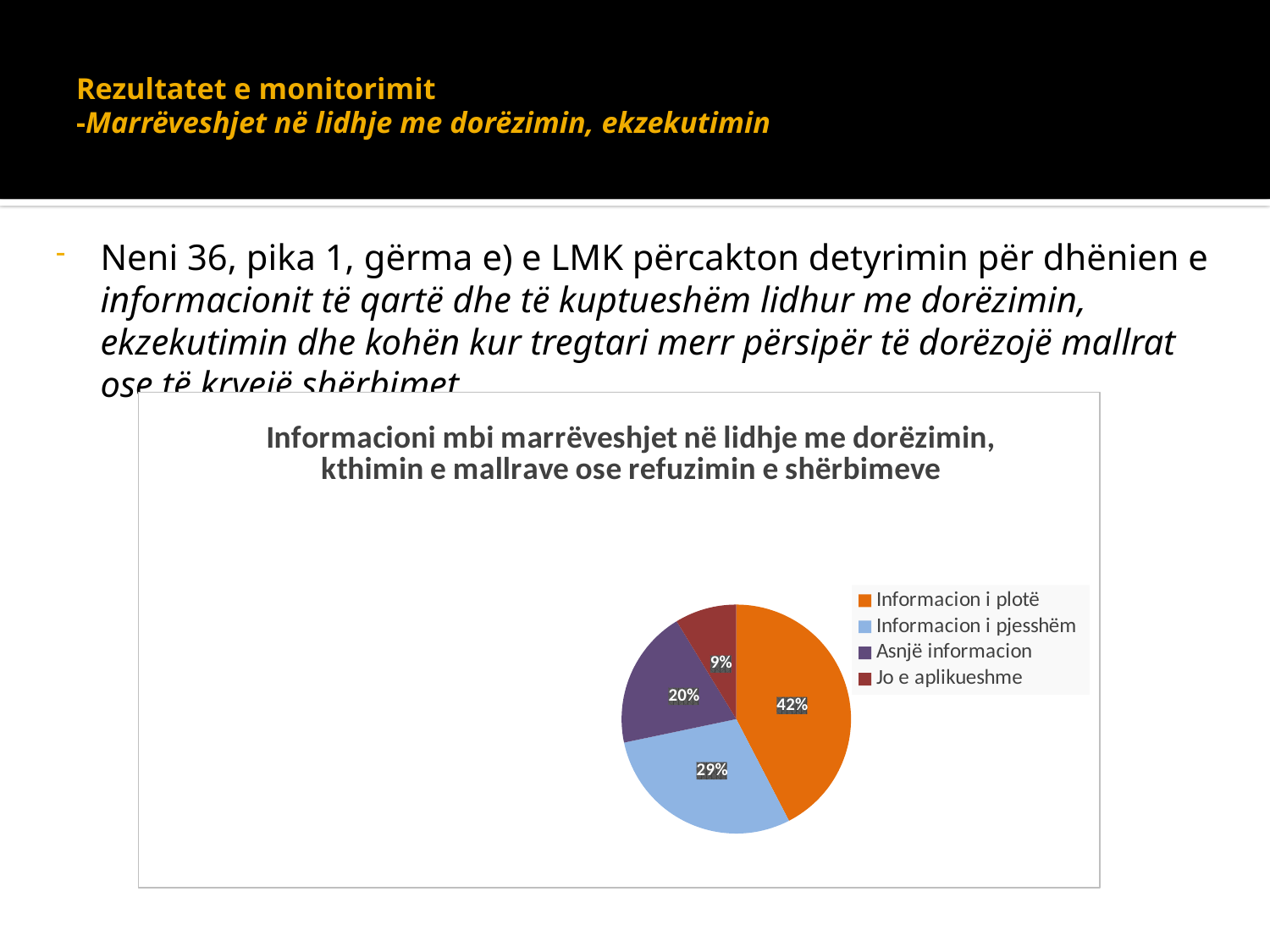
What share of the pie does "Asnjë informacion" represent? 20% What share of the pie does "Informacion i plotë" represent? 42% Which is larger, the slice for "Asnjë informacion" or the slice for "Jo e aplikueshme"? Asnjë informacion What colour is the slice for "Informacion i pjesshëm"? light blue What is the difference in percentage points between "Informacion i plotë" and "Informacion i pjesshëm"? 13% Which category has the largest slice of the pie? Informacion i plotë What kind of chart is shown on the slide? pie chart Which category has the smallest slice of the pie? Jo e aplikueshme What share of the pie does "Jo e aplikueshme" represent? 9% How many slices does the pie chart have? 4 How many entries does the legend list? 4